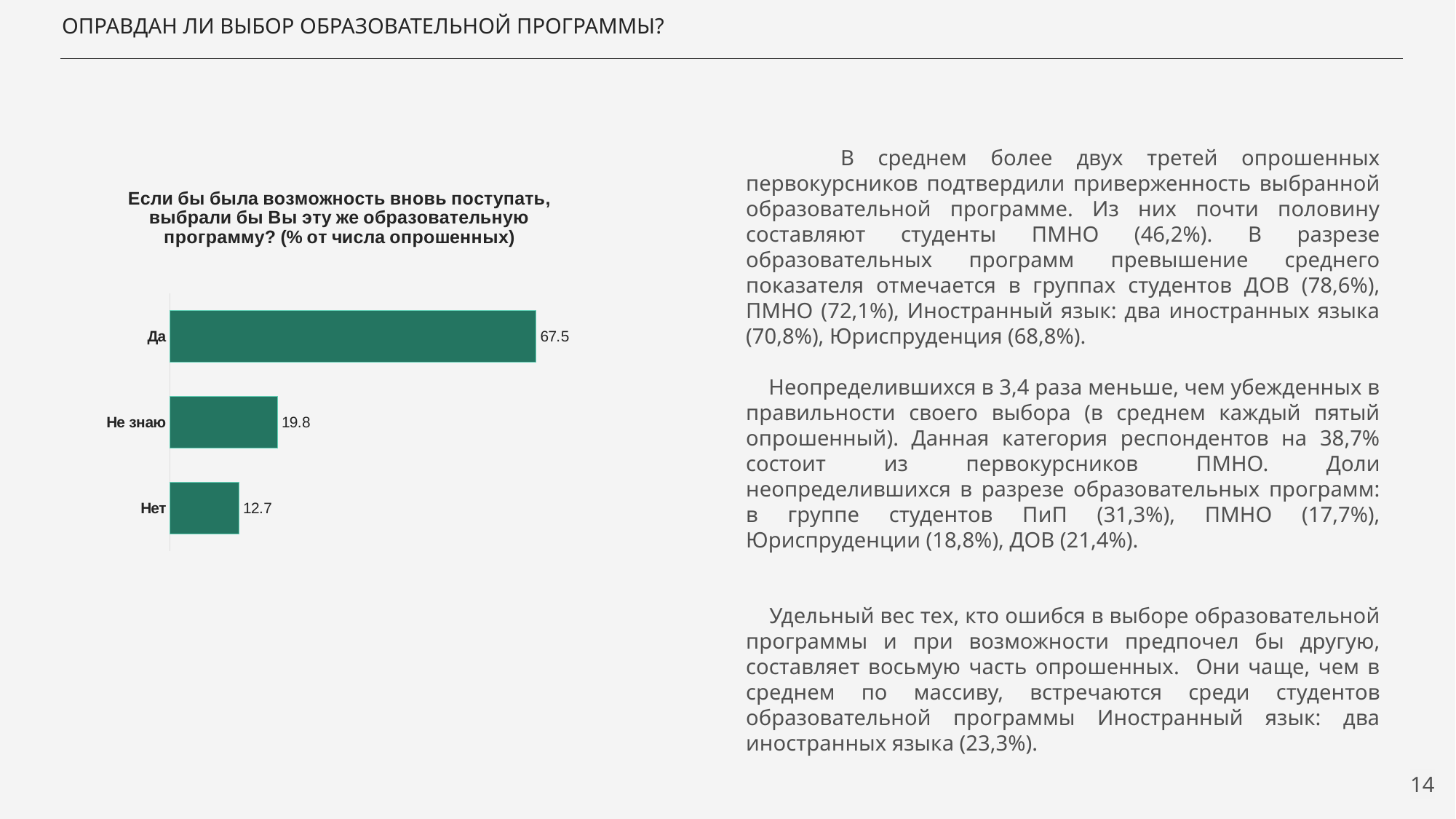
What is the difference between the values for "Не знаю" and "Нет"? 7.1 What colour are the bars in the chart? Green What is the difference between the values for "Да" and "Нет"? 54.8 What is the value for "Нет" in the chart? 12.7 Which category has the lowest value in the chart? Нет How many categories are shown in the chart? 3 What is the value for "Да" in the chart? 67.5 What is the value for "Не знаю" in the chart? 19.8 What kind of chart is shown on the slide? Bar chart Which category has the highest value in the chart? Да Which is larger: the value for "Не знаю" or the value for "Нет"? Не знаю What is the title of the chart? Если бы была возможность вновь поступать, выбрали бы Вы эту же образовательную программу? (% от числа опрошенных)